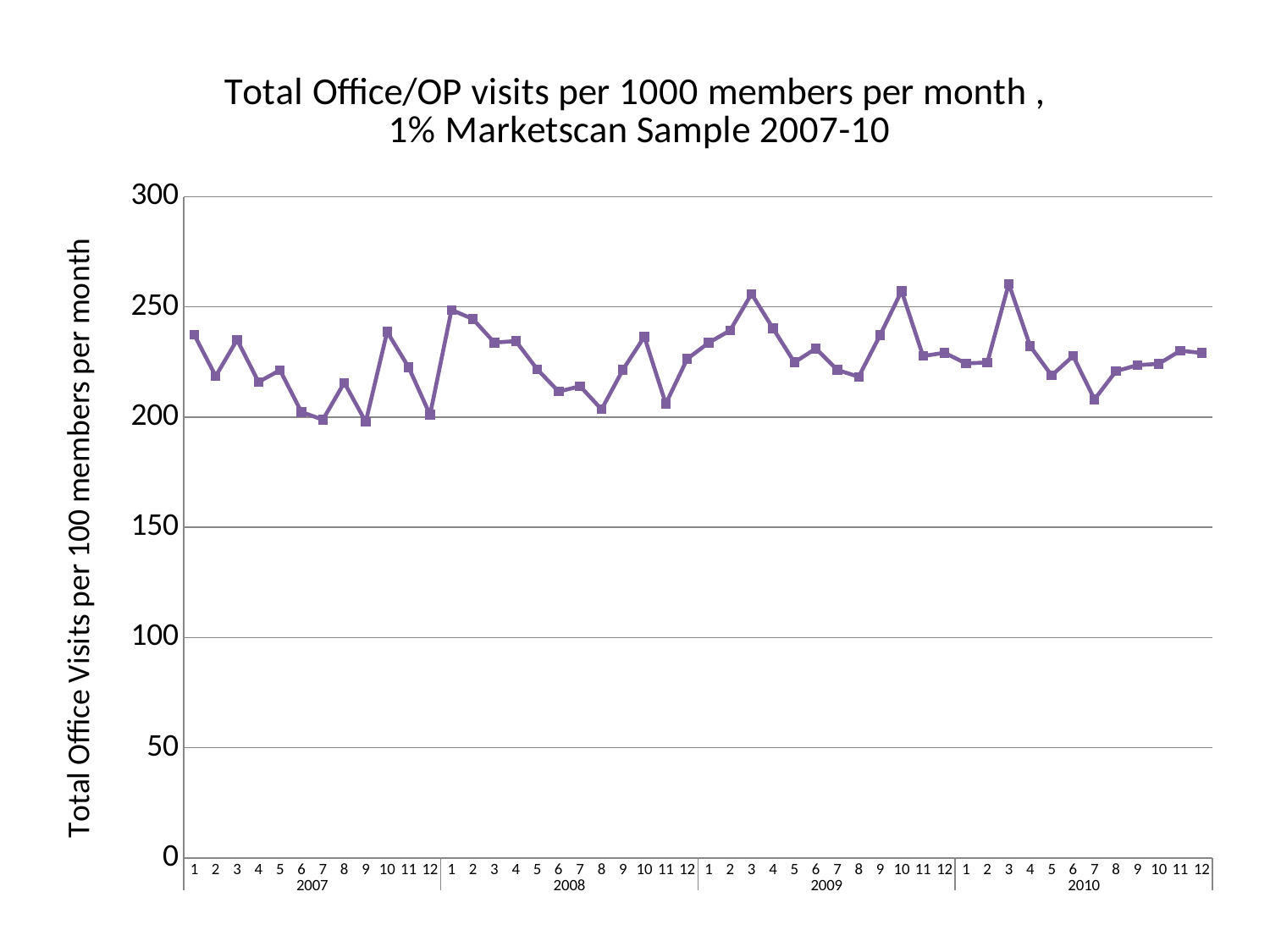
What is the title of the chart? Total Office/OP visits per 1000 members per month , 1% Marketscan Sample 2007-10 Is the value for month 3 of 2010 greater or less than 250? greater Is the value for month 3 of 2009 greater or less than 250? greater Which is larger, the value for month 1 of 2008 or the value for month 1 of 2007? month 1 of 2008 Which is larger, the value for month 3 of 2010 or the value for month 11 of 2008? month 3 of 2010 Is the value for month 1 of 2007 greater or less than 200? greater What is the label on the vertical axis of the chart? Total Office Visits per 100 members per month What kind of chart is shown on the slide? line chart How many years are shown along the x axis of the chart? 4 How many monthly data points are plotted on the chart? 48 Do the values rise or fall overall from month 1 to month 9 of 2007? fall